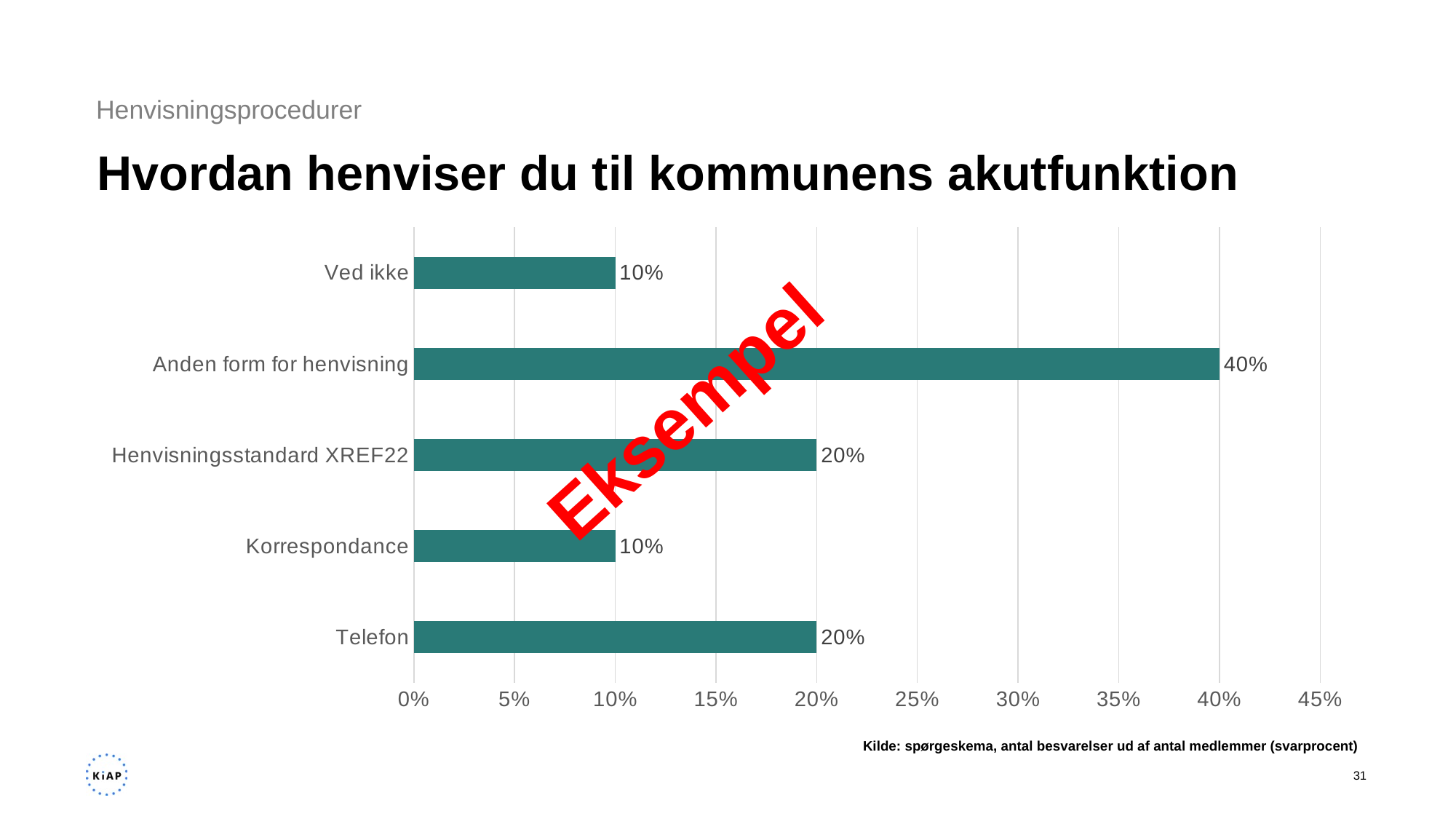
What is the value for Telefon? 20% What is the value for Henvisningsstandard XREF22? 20% How many categories are shown in the chart? 5 What kind of chart is shown on the slide? Bar chart Which is larger, Henvisningsstandard XREF22 or Korrespondance? Henvisningsstandard XREF22 What is the value for Ved ikke? 10% What is the title of the slide? Hvordan henviser du til kommunens akutfunktion Is the value for Anden form for henvisning greater or less than 35%? greater Which category has the highest value? Anden form for henvisning What is the difference between Anden form for henvisning and Korrespondance? 30% What is the value for Anden form for henvisning? 40% What is the difference between Telefon and Ved ikke? 10%